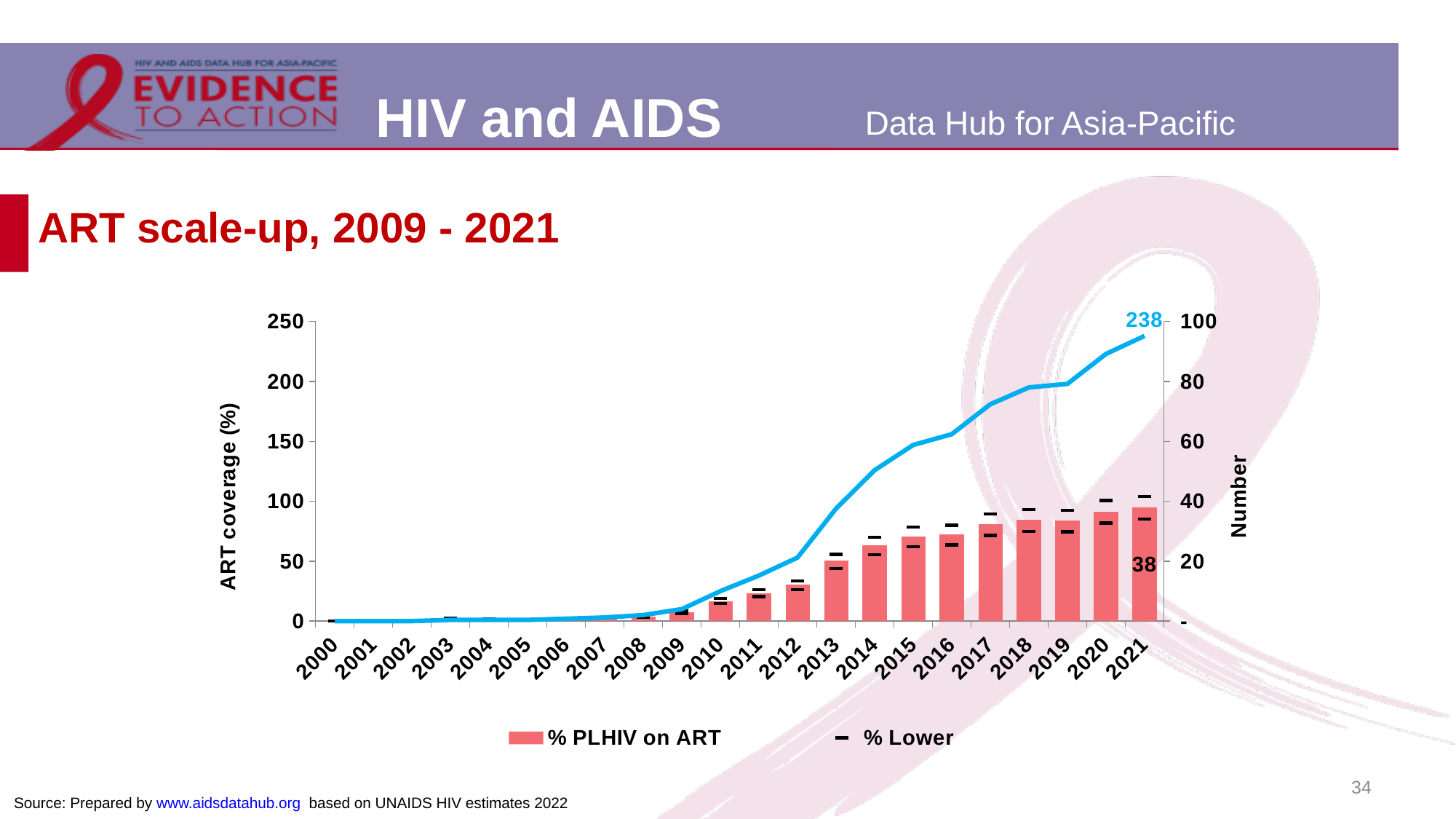
What value is labelled on the blue line for 2021? 238 How many series does the legend list? 2 What value is labelled on the bar for 2021? 38 Does the blue line rise or fall from 2009 to 2021? Rises In which year does the blue line reach its highest point? 2021 What is the title of the left-hand vertical axis? ART coverage (%) Which bar is taller, 2012 or 2017? 2017 How many years are shown along the x axis? 22 What kind of chart is this? Combined bar and line chart Is the bar for 2017 greater or less than 20 on the right-hand axis? greater Is the bar for 2010 greater or less than 20 on the right-hand axis? less Is the blue line value for 2015 greater or less than 100 on the left-hand axis? greater